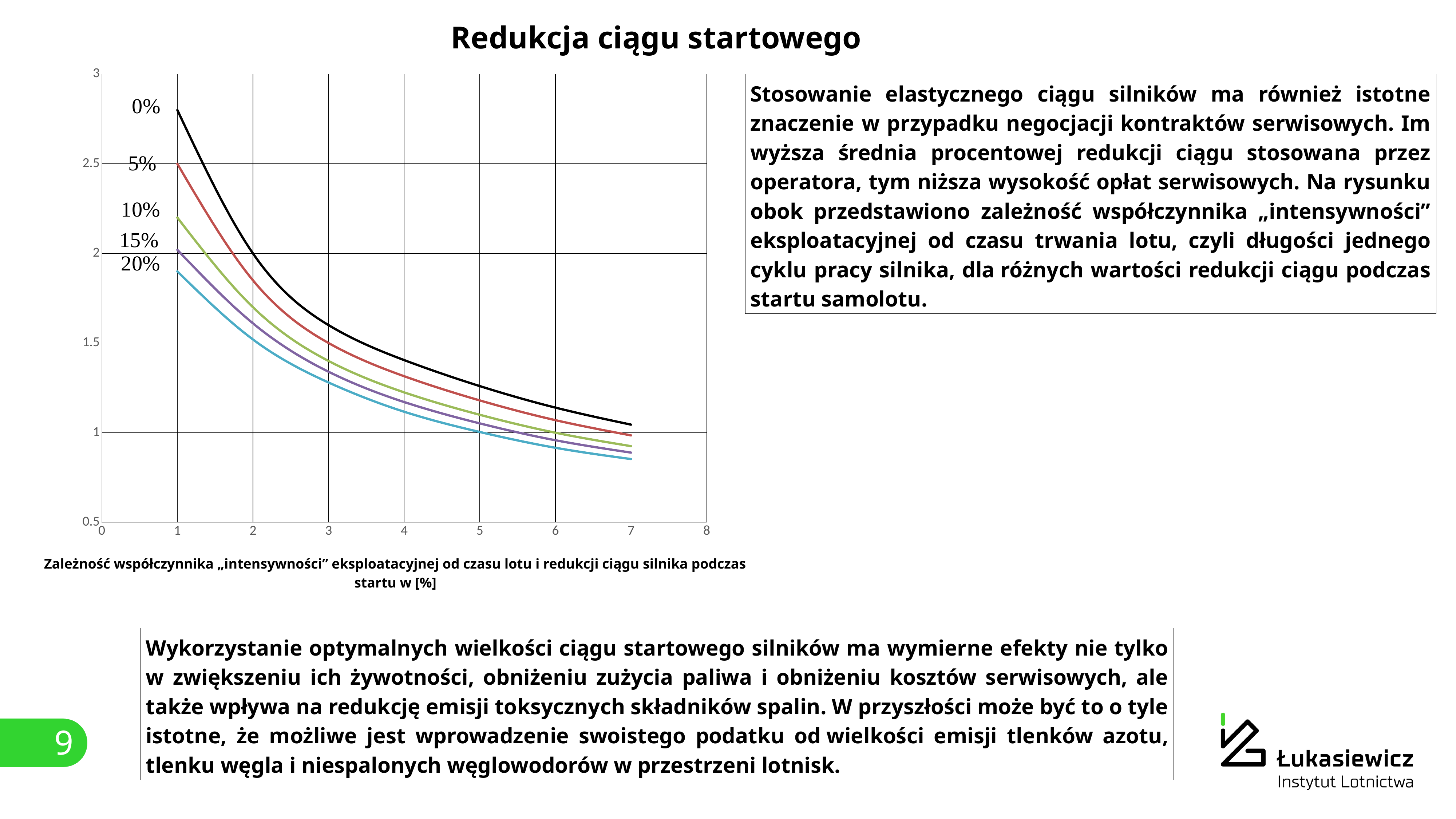
Which curve lies lowest on the chart across the whole x-axis range? 20% Do the curves rise or fall as the value on the x axis increases? fall Is the value of the 20% curve at x = 1 greater or less than 2? less Is the value of the 20% curve at x = 7 greater or less than 1? less Which curve lies highest on the chart across the whole x-axis range? 0% How many curves (thrust reduction levels) are plotted on the chart? 5 Is the value of the 0% curve at x = 1 greater or less than 2.5? greater What kind of chart is shown on the slide? line chart What is the highest value shown on the y axis? 3 At x = 1, which curve has the larger value, 0% or 20%? 0% What is the title of the slide containing the chart? Redukcja ciągu startowego